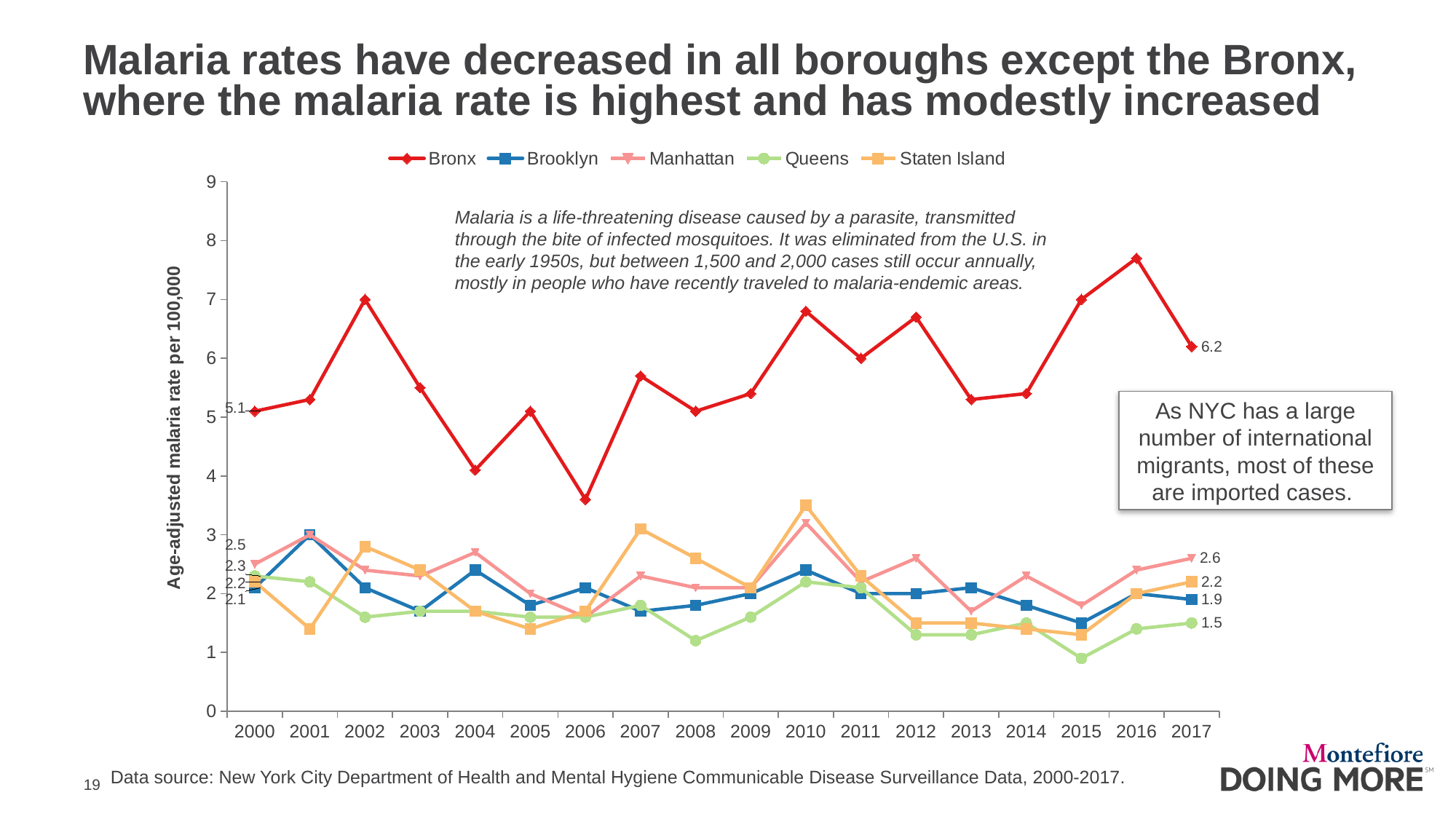
What is Manhattan's age-adjusted malaria rate per 100,000 in 2017? 2.6 Is the Bronx's malaria rate in 2006 greater or less than 4? less What is Queens' age-adjusted malaria rate per 100,000 in 2017? 1.5 In 2017, which has the higher malaria rate, Manhattan or Staten Island? Manhattan What is the Bronx's age-adjusted malaria rate per 100,000 in 2017? 6.2 How many series does the legend list? 5 Which borough has the highest malaria rate in 2017? Bronx What kind of chart is shown on the slide? Line chart What is Brooklyn's age-adjusted malaria rate per 100,000 in 2017? 1.9 What is the Bronx's age-adjusted malaria rate per 100,000 in 2000? 5.1 What is the difference between the Bronx and Manhattan malaria rates in 2017? 3.6 By how much did the Bronx's malaria rate change between 2000 and 2017? 1.1